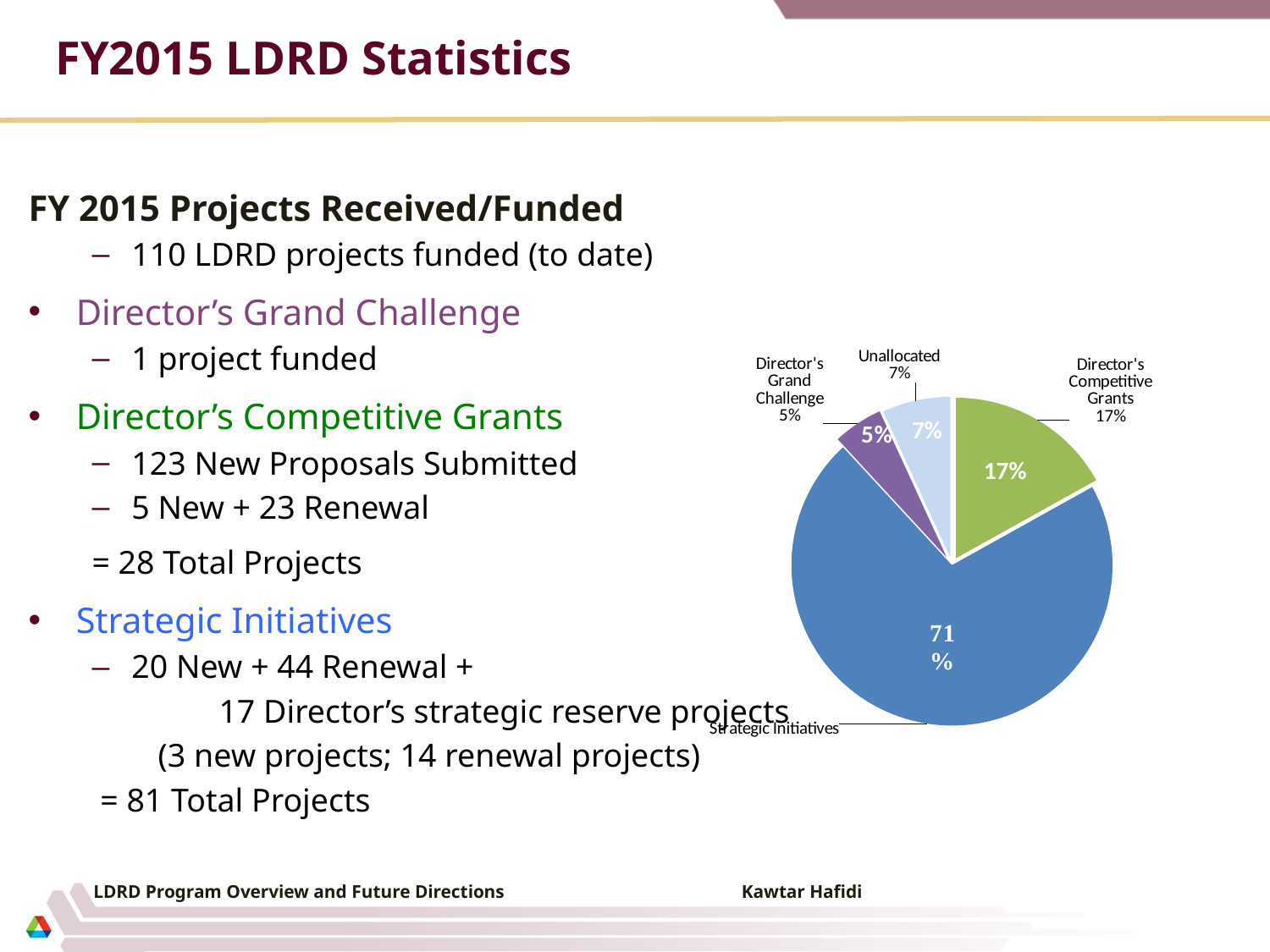
What colour is the Director's Competitive Grants slice? Green Which slice of the pie chart is the smallest? Director's Grand Challenge What share of the pie does Director's Grand Challenge represent? 5% How many slices does the pie chart have? 4 What share of the pie does Director's Competitive Grants represent? 17% What is the difference in percentage points between Unallocated and Director's Grand Challenge? 2 What share of the pie does Strategic Initiatives represent? 71% What is the difference in percentage points between Strategic Initiatives and Director's Competitive Grants? 54 What kind of chart is shown on the slide? Pie chart Which slice of the pie chart is the largest? Strategic Initiatives Which is larger, the Unallocated slice or the Director's Grand Challenge slice? Unallocated